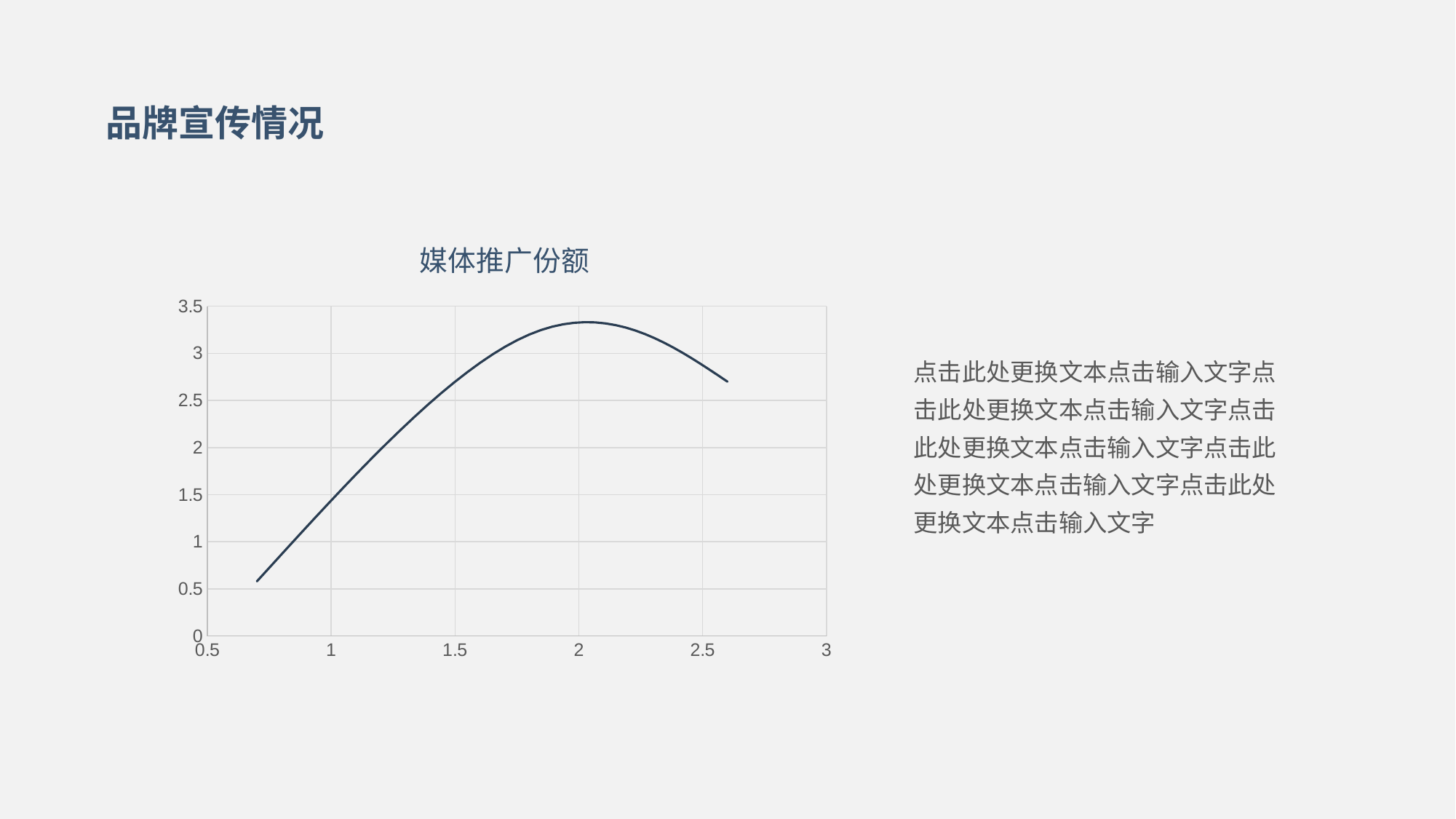
Is the value of the line at x = 2 greater or less than 3? greater Is the value of the line at x = 2.5 greater or less than 3? less Is the value of the line at x = 1 greater or less than 1? greater Does the line rise or fall between x = 1 and x = 2? rise Is the value of the line higher at x = 2 or at x = 1? x = 2 What is the title of the chart? 媒体推广份额 What kind of chart is shown on the slide? line chart What is the highest value shown on the vertical axis? 3.5 Does the line rise or fall between x = 2 and x = 2.5? fall